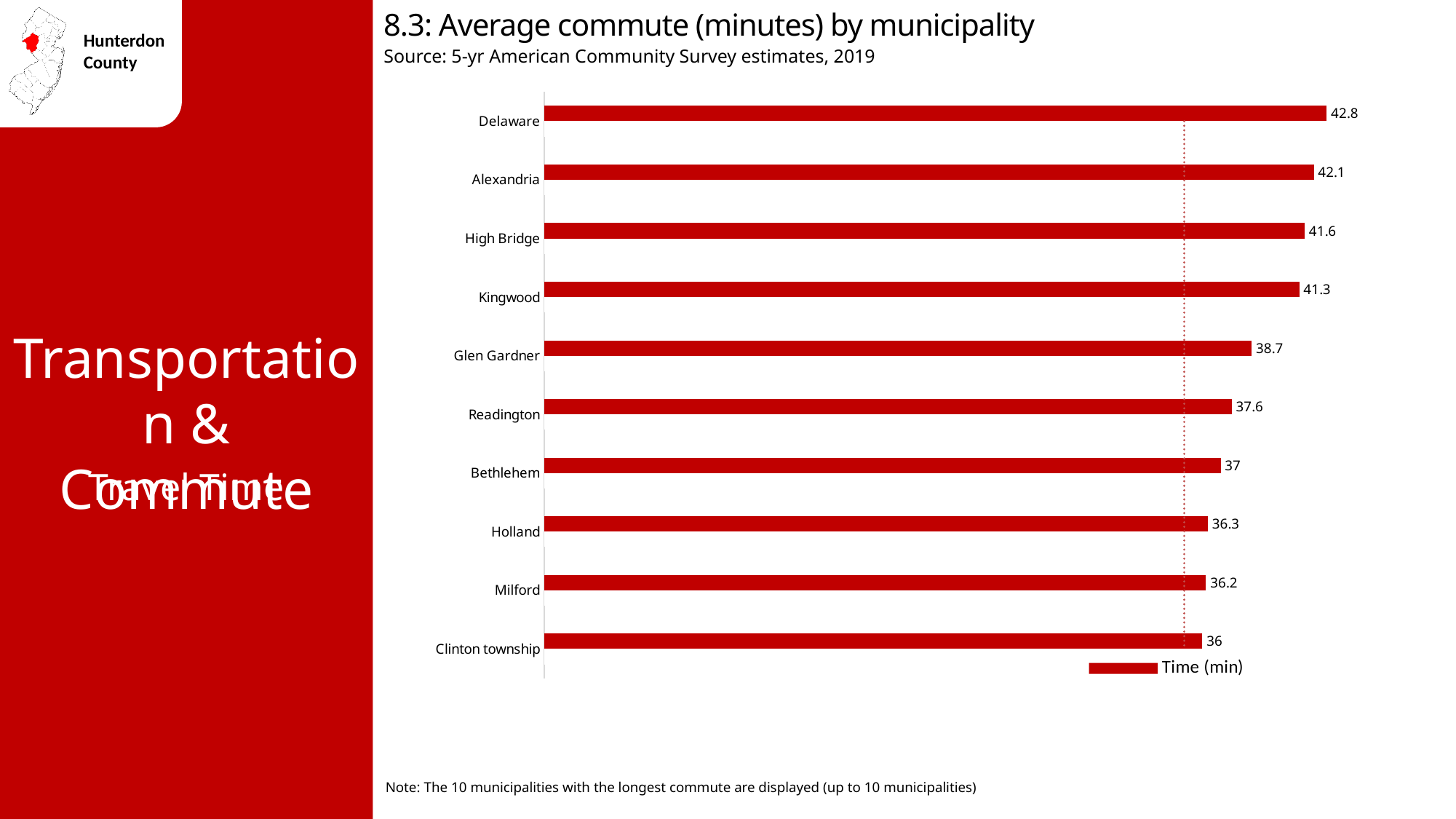
What is the average commute time for Glen Gardner? 38.7 What kind of chart is shown on the slide? Bar chart Which municipality has the longest average commute? Delaware What is the average commute time for Milford? 36.2 How many municipalities are shown in the chart? 10 What is the difference in average commute time between Delaware and Clinton township? 6.8 Which municipality shown has the shortest average commute? Clinton township Which has a longer average commute, Kingwood or Bethlehem? Kingwood What is the difference in average commute time between High Bridge and Readington? 4 How many series does the legend list? 1 What is the legend entry for the series in the chart? Time (min) What is the average commute time for Delaware? 42.8